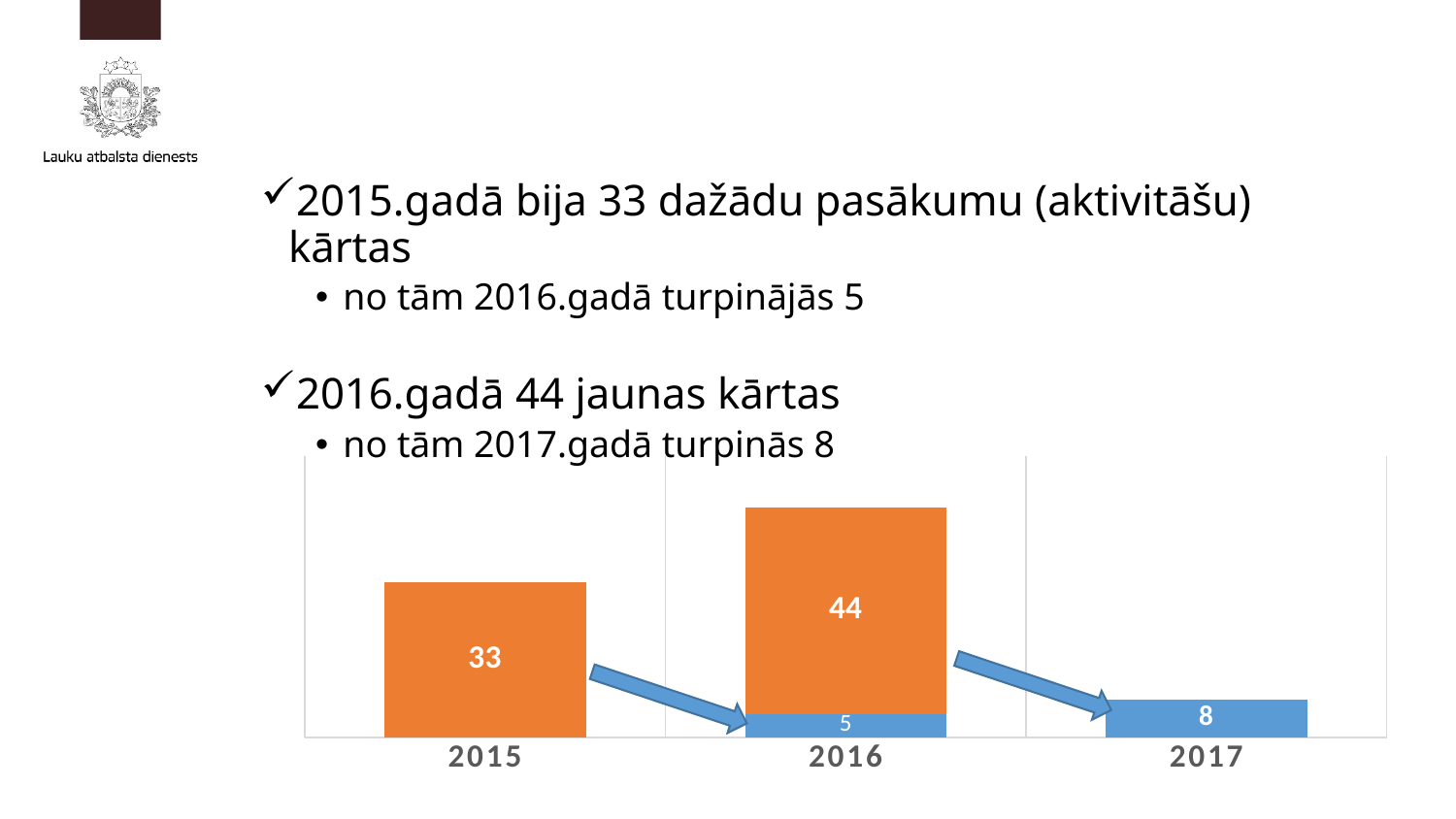
What is the total of the stacked bar for 2016? 49 What colour is the segment labelled 5 in the 2016 bar? blue What is the value of the orange bar for 2016? 44 What kind of chart is shown on the slide? bar chart Which is larger, the blue value for 2017 or the blue value for 2016? 2017 What is the value of the blue segment for 2016? 5 What is the value of the orange bar for 2015? 33 How many years are shown on the x axis? 3 What is the difference between the orange values for 2016 and 2015? 11 Which year has the shortest bar? 2017 What is the value of the blue bar for 2017? 8 Which year has the tallest bar? 2016